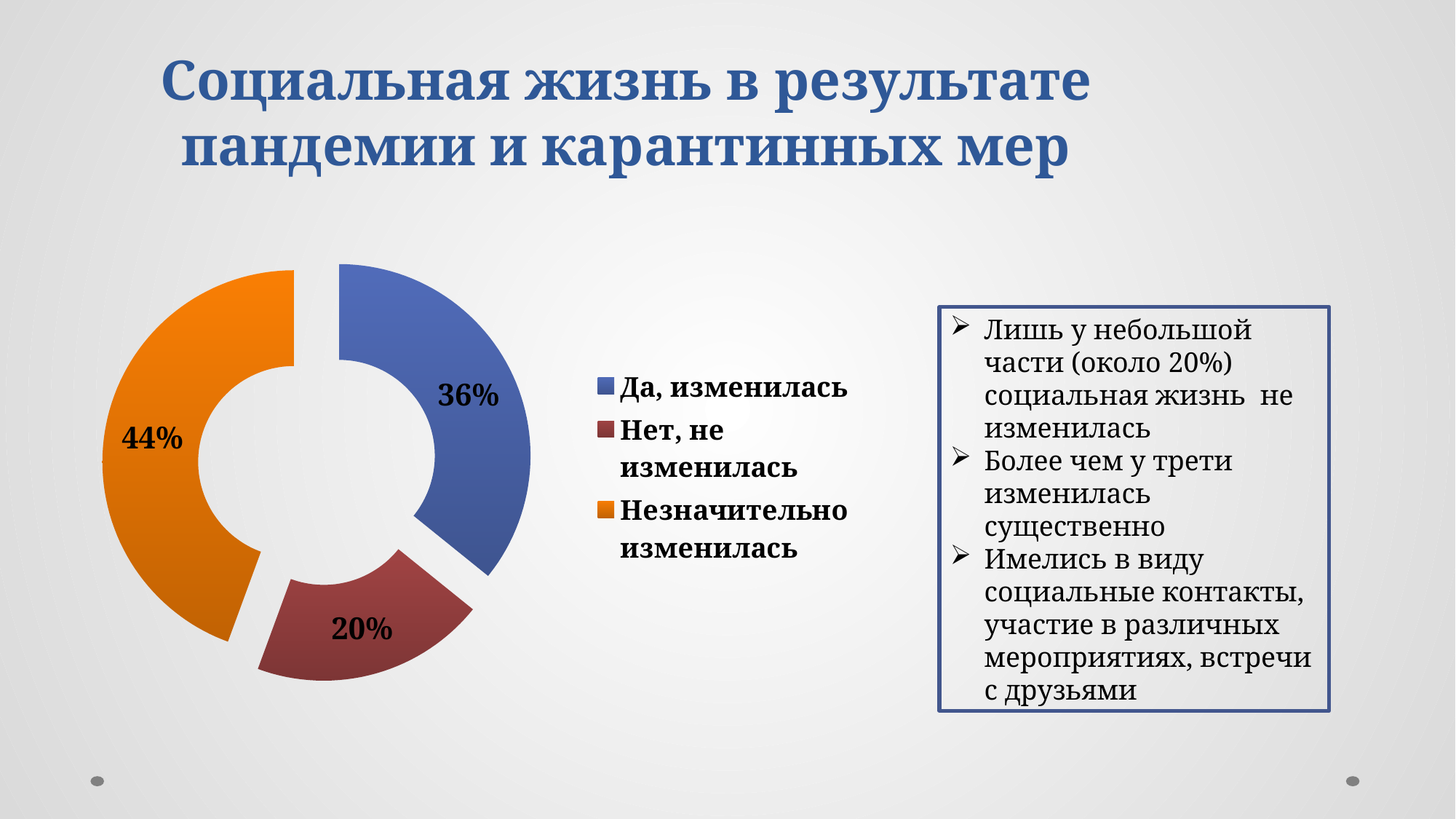
Which is larger: the share for "Да, изменилась" or the share for "Нет, не изменилась"? Да, изменилась What is the difference in percentage points between "Незначительно изменилась" and "Да, изменилась"? 8 What percentage is shown for "Да, изменилась"? 36% What is the difference in percentage points between "Да, изменилась" and "Нет, не изменилась"? 16 Which category has the smallest share of the chart? Нет, не изменилась What percentage is shown for "Нет, не изменилась"? 20% Which category has the largest share of the chart? Незначительно изменилась How many categories does the chart show? 3 What colour represents "Незначительно изменилась" in the chart? Orange What percentage is shown for "Незначительно изменилась"? 44% What kind of chart is shown on the slide? Doughnut chart What colour represents "Да, изменилась" in the chart? Blue